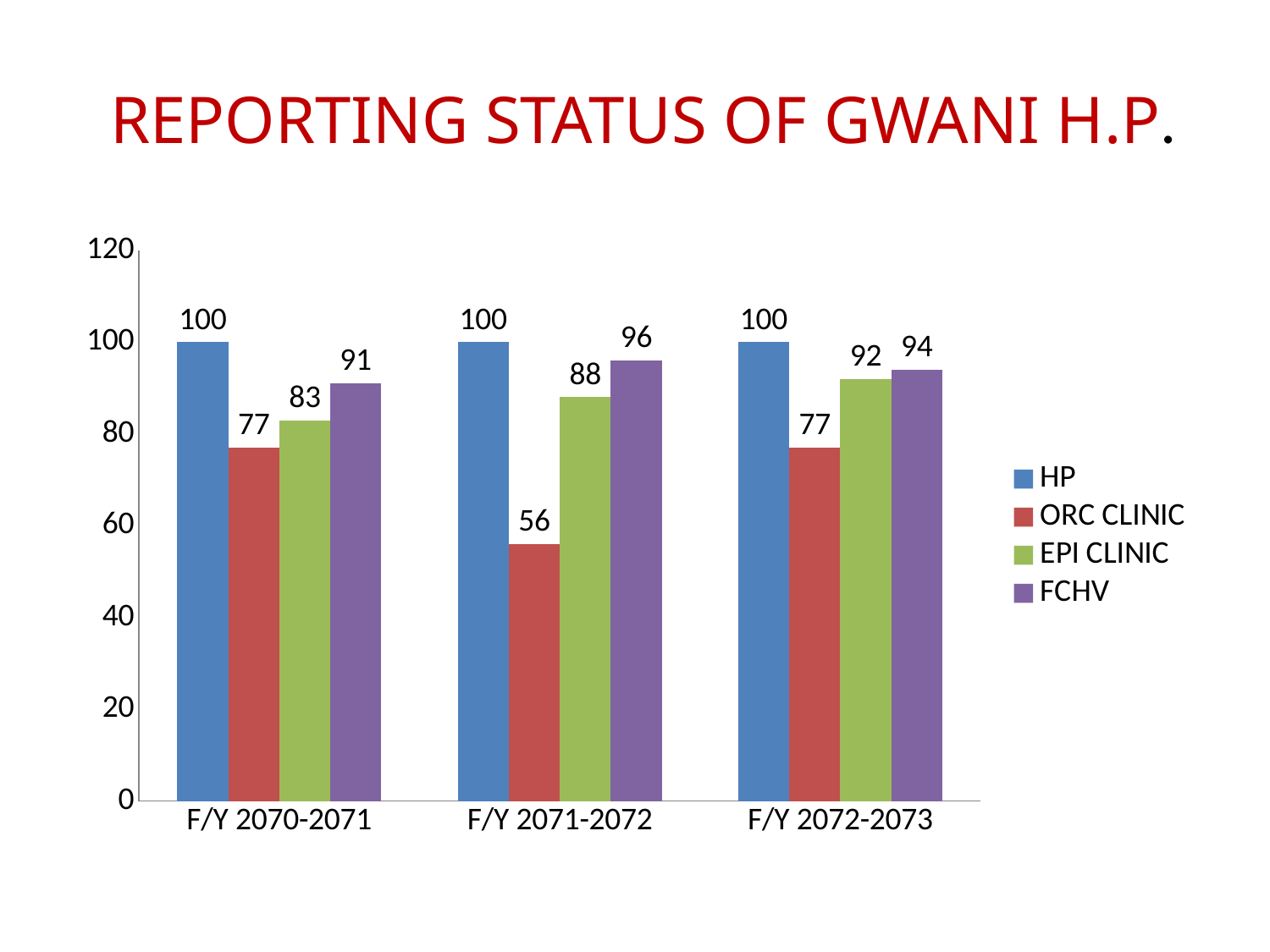
What is the value for ORC CLINIC in F/Y 2071-2072? 56 Which is larger, the EPI CLINIC value in F/Y 2070-2071 or the EPI CLINIC value in F/Y 2072-2073? F/Y 2072-2073 Which series has the lowest value in F/Y 2071-2072? ORC CLINIC How many fiscal year categories are shown on the x axis? 3 What is the value for EPI CLINIC in F/Y 2072-2073? 92 What is the difference between the FCHV value and the ORC CLINIC value in F/Y 2071-2072? 40 What is the title of the chart? REPORTING STATUS OF GWANI H.P. What is the value for FCHV in F/Y 2070-2071? 91 How many series does the legend list? 4 Do the EPI CLINIC values rise or fall from F/Y 2070-2071 to F/Y 2072-2073? Rise What kind of chart is shown on the slide? Bar chart Which series has the highest value in F/Y 2072-2073? HP